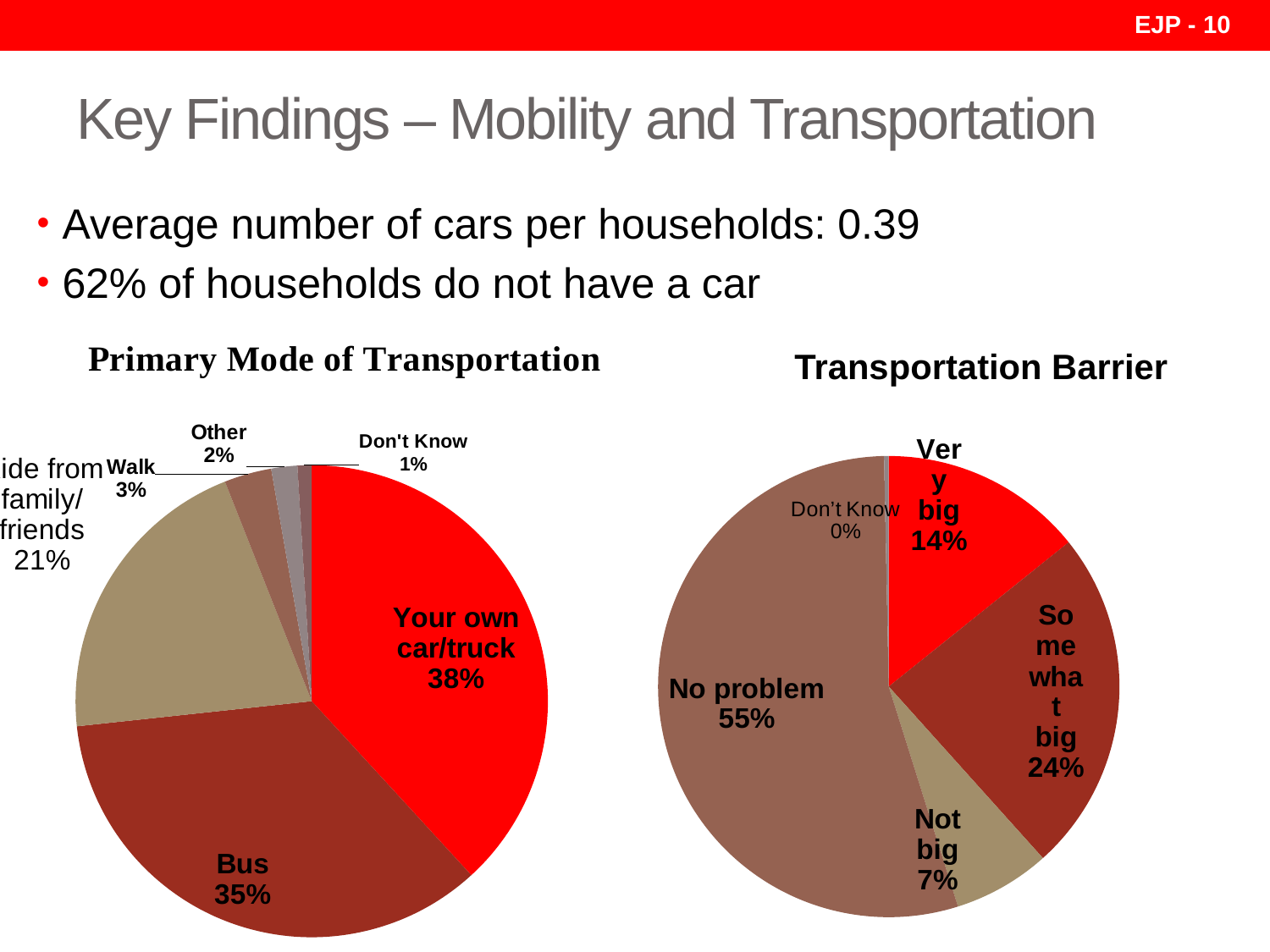
In the Transportation Barrier chart, what percentage is shown for Somewhat big? 24% In the Primary Mode of Transportation chart, what percentage is shown for Bus? 35% In the Primary Mode of Transportation chart, which category has the largest share? Your own car/truck In the Transportation Barrier chart, what percentage is shown for Not big? 7% What type of chart is the Transportation Barrier chart? Pie chart In the Primary Mode of Transportation chart, what is the difference between the Your own car/truck share and the Bus share? 3% In the Primary Mode of Transportation chart, what percentage is shown for Your own car/truck? 38% In the Transportation Barrier chart, what percentage is shown for No problem? 55% In the Primary Mode of Transportation chart, which category has the smallest share? Don't Know In the Transportation Barrier chart, how many categories are labelled? 5 In the Primary Mode of Transportation chart, what percentage is shown for Walk? 3% In the Transportation Barrier chart, which is larger, Very big or Somewhat big? Somewhat big